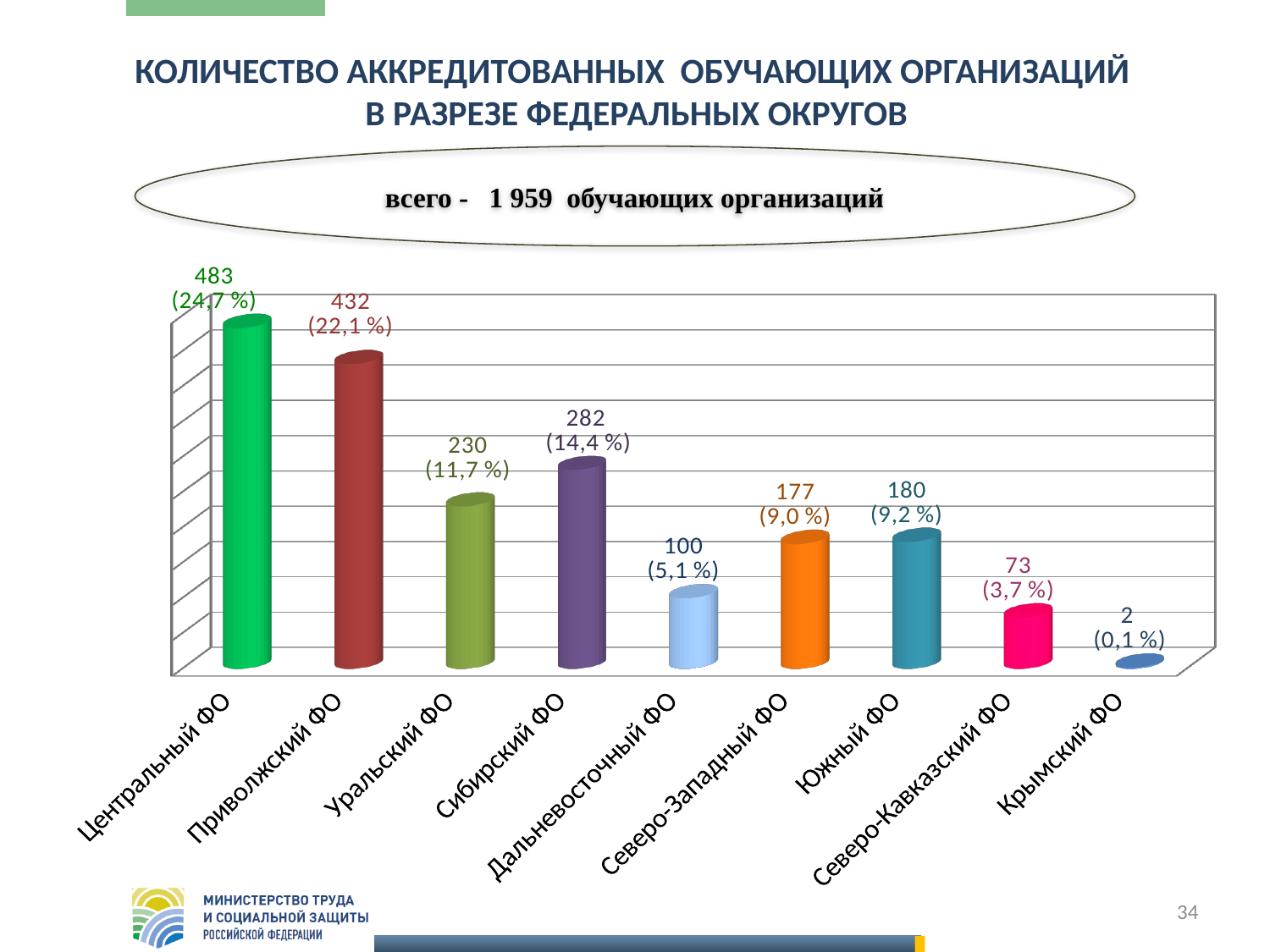
What kind of chart is shown on the slide? bar chart What value is shown for Сибирский ФО? 282 What value is shown for Северо-Кавказский ФО? 73 What percentage share is shown for Уральский ФО? 11,7 % What total number of training organisations is stated on the slide? 1 959 What is the difference between the values for Центральный ФО and Приволжский ФО? 51 How many federal districts are shown on the chart? 9 What is the difference between the values for Южный ФО and Северо-Западный ФО? 3 Which is larger, the value for Сибирский ФО or the value for Уральский ФО? Сибирский ФО Which federal district has the highest value? Центральный ФО What value is shown for Центральный ФО? 483 Which federal district has the lowest value? Крымский ФО